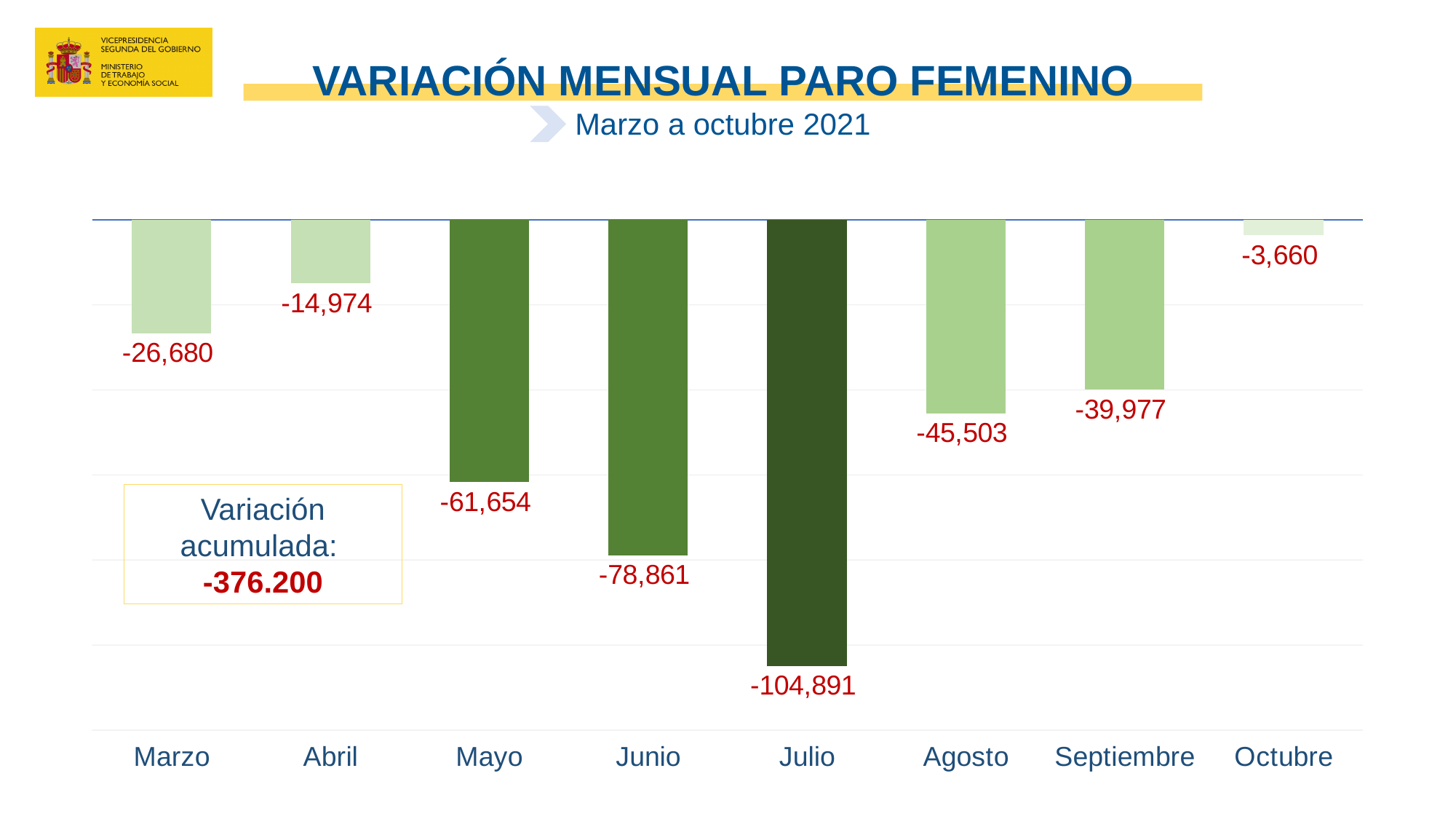
Which month has the highest value (smallest decrease)? Octubre How many months are plotted in the chart? 8 What is the value for Julio? -104,891 What is the value for Septiembre? -39,977 What is the accumulated variation (Variación acumulada) shown on the slide? -376.200 Which month has the lowest (most negative) value? Julio Which month shows a larger decrease, Mayo or Agosto? Mayo What is the value for Abril? -14,974 What is the difference between the values for Julio and Junio? 26,030 What kind of chart is shown on the slide? Bar chart What is the value for Octubre? -3,660